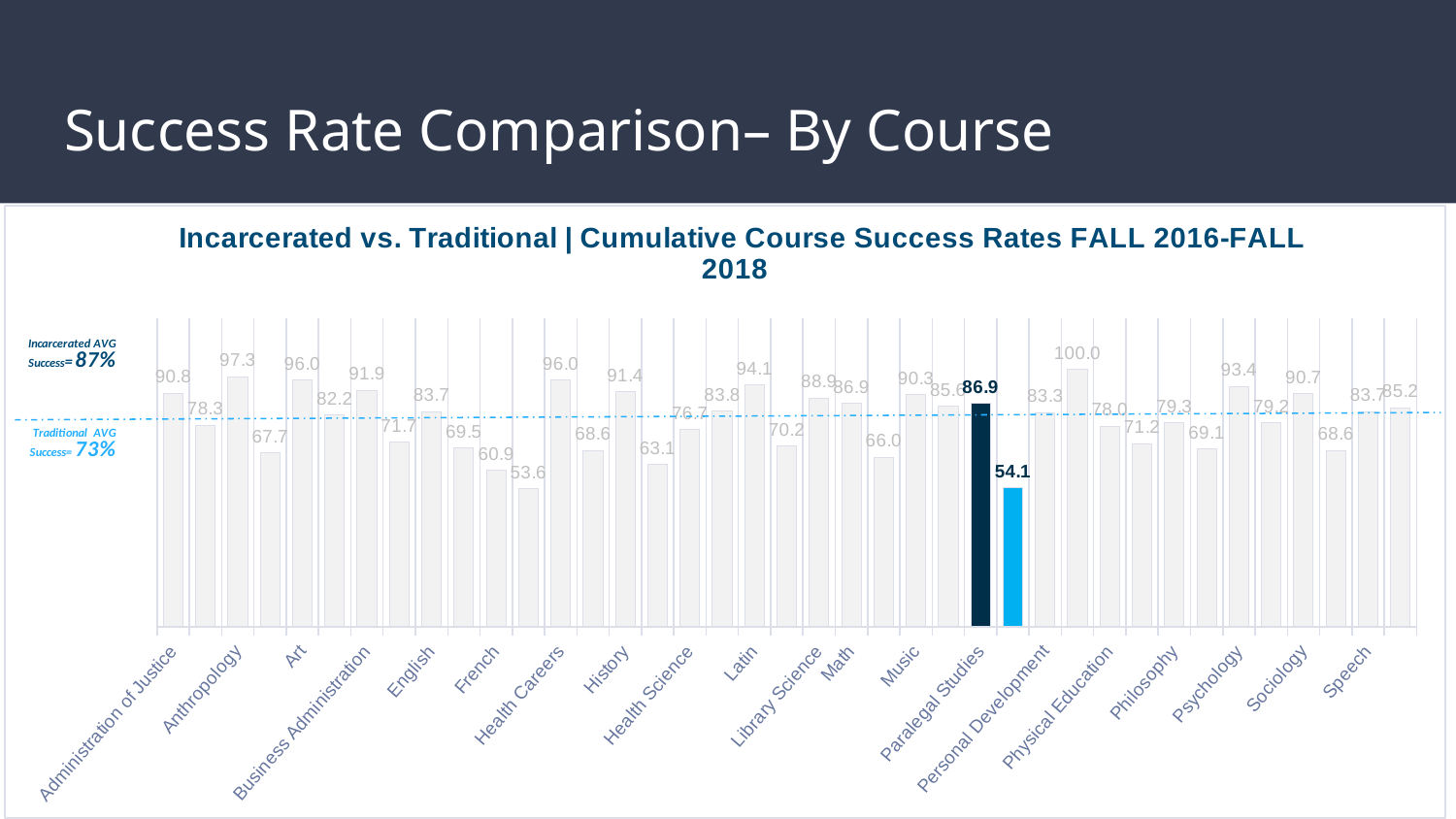
What is the Incarcerated AVG Success rate shown on the left of the chart? 87% How many courses are listed along the x axis of the chart? 20 What is the value of the dark navy highlighted bar for Paralegal Studies? 86.9 What is the highest value labelled on the chart? 100.0 What is the difference between the two bars for Paralegal Studies (86.9 and 54.1)? 32.8 What is the value of the first bar for Administration of Justice? 90.8 Which course has the bar labelled 53.6? French What is the title of the chart? Incarcerated vs. Traditional | Cumulative Course Success Rates FALL 2016-FALL 2018 What is the lowest value labelled on the chart? 53.6 Which course has the bar labelled 100.0? Personal Development What kind of chart is shown on the slide? bar chart What is the value of the light blue highlighted bar for Paralegal Studies? 54.1